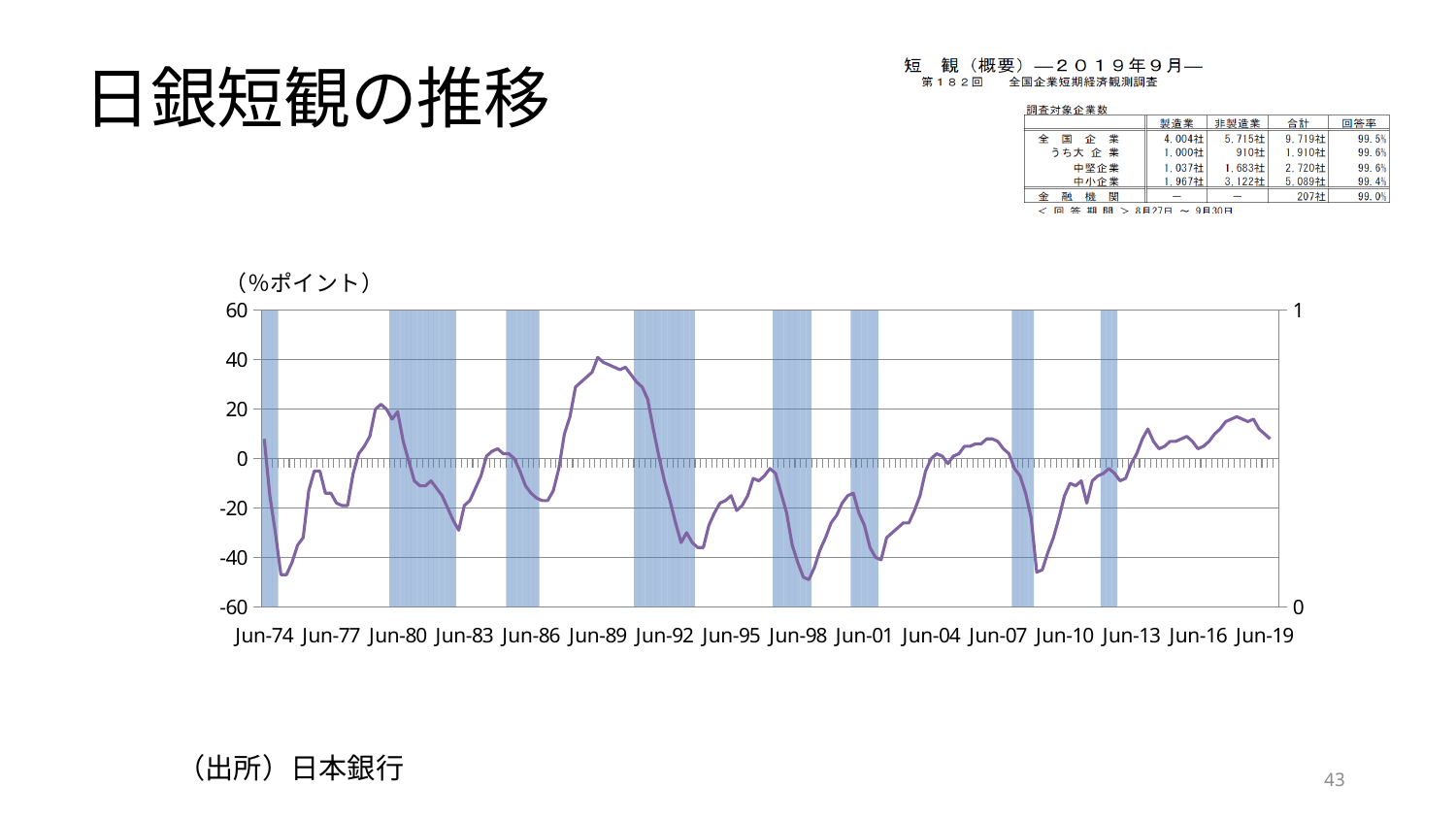
How many date labels are shown along the x axis of the chart? 16 Is the value of the line at Jun-98 greater or less than -20? less What unit label is printed above the left vertical axis of the chart? （%ポイント） What kind of chart is shown on the slide? line chart Which is higher, the value of the line at Jun-89 or at Jun-98? Jun-89 Is the value of the line at Jun-19 greater or less than 0? greater Is the value of the line at Jun-89 greater or less than 20? greater Near which x-axis label does the line reach its highest point? Jun-89 What is the highest value shown on the left vertical axis of the chart? 60 Does the line rise or fall between Jun-86 and Jun-89? rise